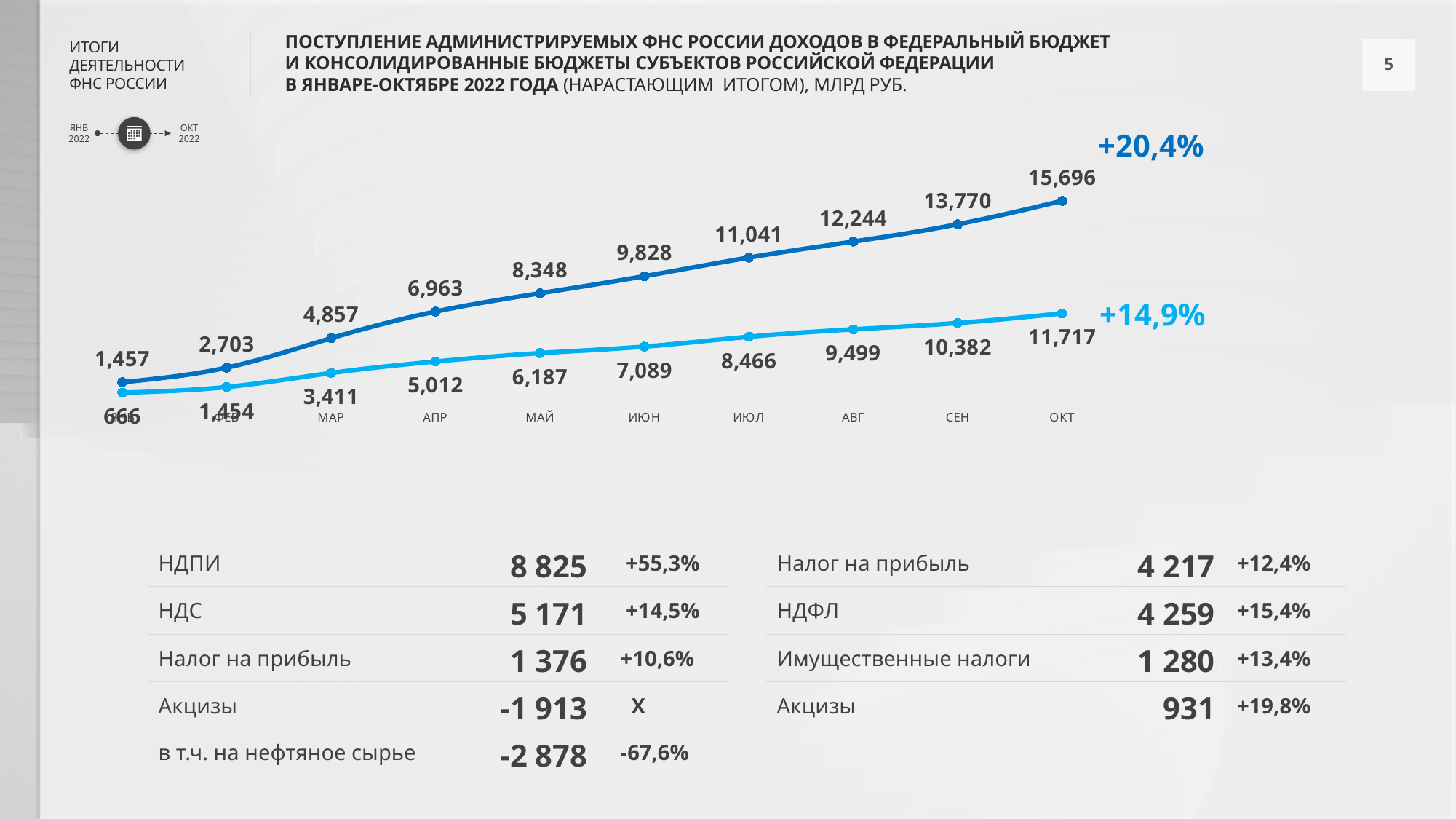
What kind of chart is shown on the slide? line chart What is the value of the light blue (lower) line for ОКТ? 11,717 In which month does the dark blue (upper) line reach its highest value? ОКТ What is the difference between the dark blue and light blue line values for ОКТ? 3,979 What is the value of the dark blue (upper) line for МАЙ? 8,348 What is the value of the light blue (lower) line for АВГ? 9,499 What is the value of the dark blue (upper) line for ОКТ? 15,696 How many monthly data points does each line on the chart have? 10 Which line has the higher value for ИЮН, the dark blue or the light blue? dark blue Do the values of the dark blue line rise or fall from left to right along the x axis? rise What is the lowest value shown on the light blue (lower) line? 666 What growth percentage is printed next to the end of the dark blue (upper) line? +20,4%